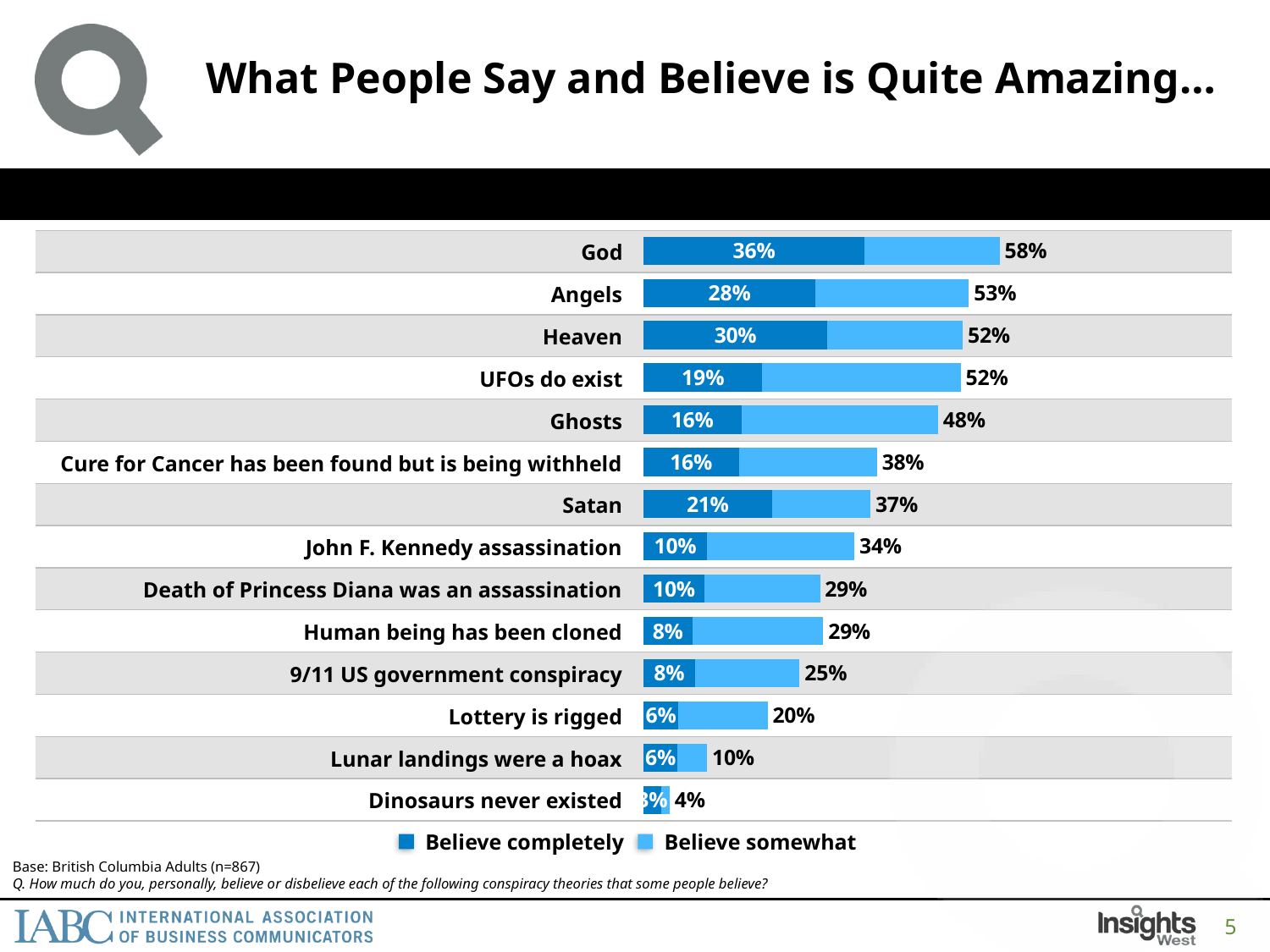
How many categories are shown in the chart? 14 Which has a larger 'Believe completely' value, Heaven or Satan? Heaven What total percentage is shown at the end of the bar for 'Lottery is rigged'? 20% Which category has the highest total percentage shown at the end of its bar? God How many series does the legend list? 2 What is the difference between the 'Believe completely' value for Satan and the 'Believe completely' value for 'UFOs do exist'? 2% What is the difference between the total percentage for God and the total percentage for Angels? 5% What are the two legend entries of the chart? Believe completely; Believe somewhat What total percentage is shown at the end of the bar for Ghosts? 48% Which category has the lowest total percentage shown at the end of its bar? Dinosaurs never existed What is the 'Believe completely' value for God? 36% What kind of chart is shown on the slide? Stacked bar chart